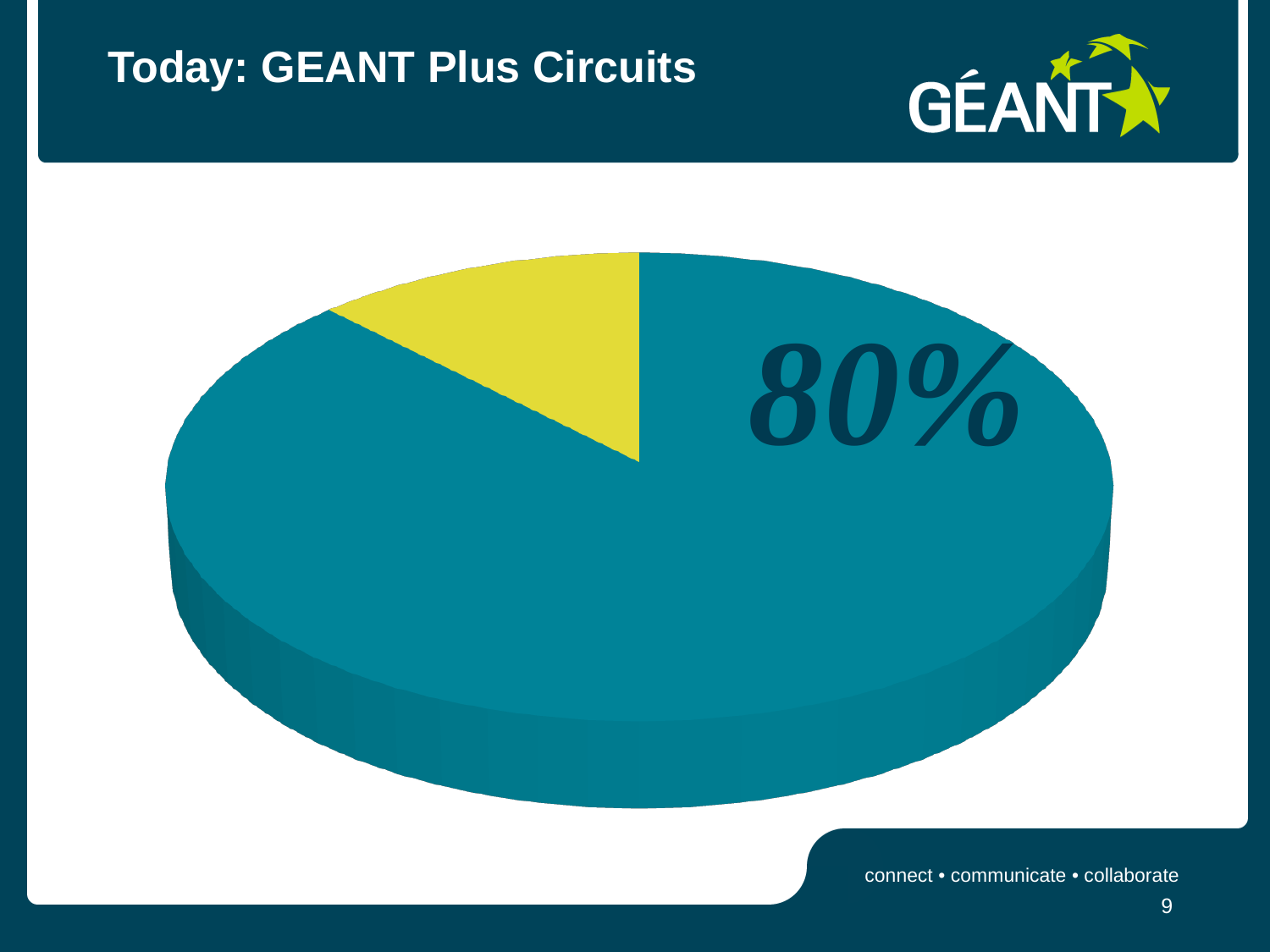
How many slices does the pie chart have? 2 What colour is the slice labelled 80%? teal Which slice of the pie chart is the largest? the teal slice (80%) What is the title of the slide containing the pie chart? Today: GEANT Plus Circuits Which slice is larger, the teal slice or the yellow slice? the teal slice Which slice of the pie chart is the smallest? the yellow slice What share of the pie does the teal slice represent? 80% What percentage is printed on the large teal slice of the pie chart? 80% What kind of chart is shown on the slide? pie chart